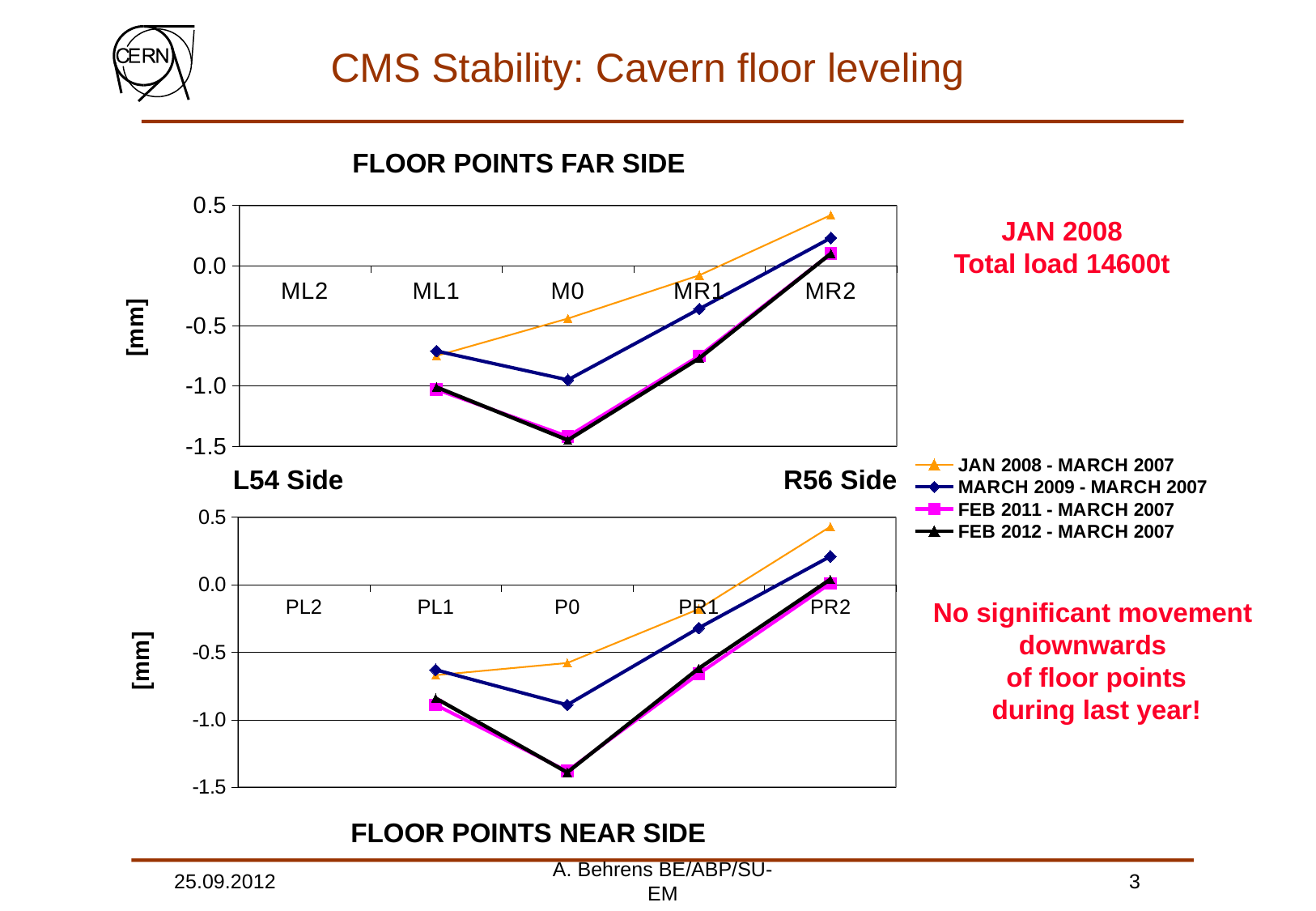
In the FLOOR POINTS FAR SIDE chart, is the JAN 2008 - MARCH 2007 value at MR2 greater or less than 0.0? greater How many category labels appear on the x axis of the FLOOR POINTS NEAR SIDE chart? 5 In the FLOOR POINTS NEAR SIDE chart, do the FEB 2011 - MARCH 2007 values rise or fall from P0 to PR2? rise In the FLOOR POINTS FAR SIDE chart, is the MARCH 2009 - MARCH 2007 value at M0 greater or less than -0.5? less In the FLOOR POINTS FAR SIDE chart, at which floor point does the JAN 2008 - MARCH 2007 series reach its highest value? MR2 In the FLOOR POINTS NEAR SIDE chart, is the MARCH 2009 - MARCH 2007 value at P0 greater or less than -0.5? less In the FLOOR POINTS FAR SIDE chart, at M0, which is higher: the JAN 2008 - MARCH 2007 value or the MARCH 2009 - MARCH 2007 value? JAN 2008 - MARCH 2007 How many series does the legend list? 4 What unit is shown on the y axis of the charts? [mm] What kind of chart is the FLOOR POINTS FAR SIDE chart? line chart In the FLOOR POINTS NEAR SIDE chart, at which floor point does the FEB 2012 - MARCH 2007 series reach its lowest value? P0